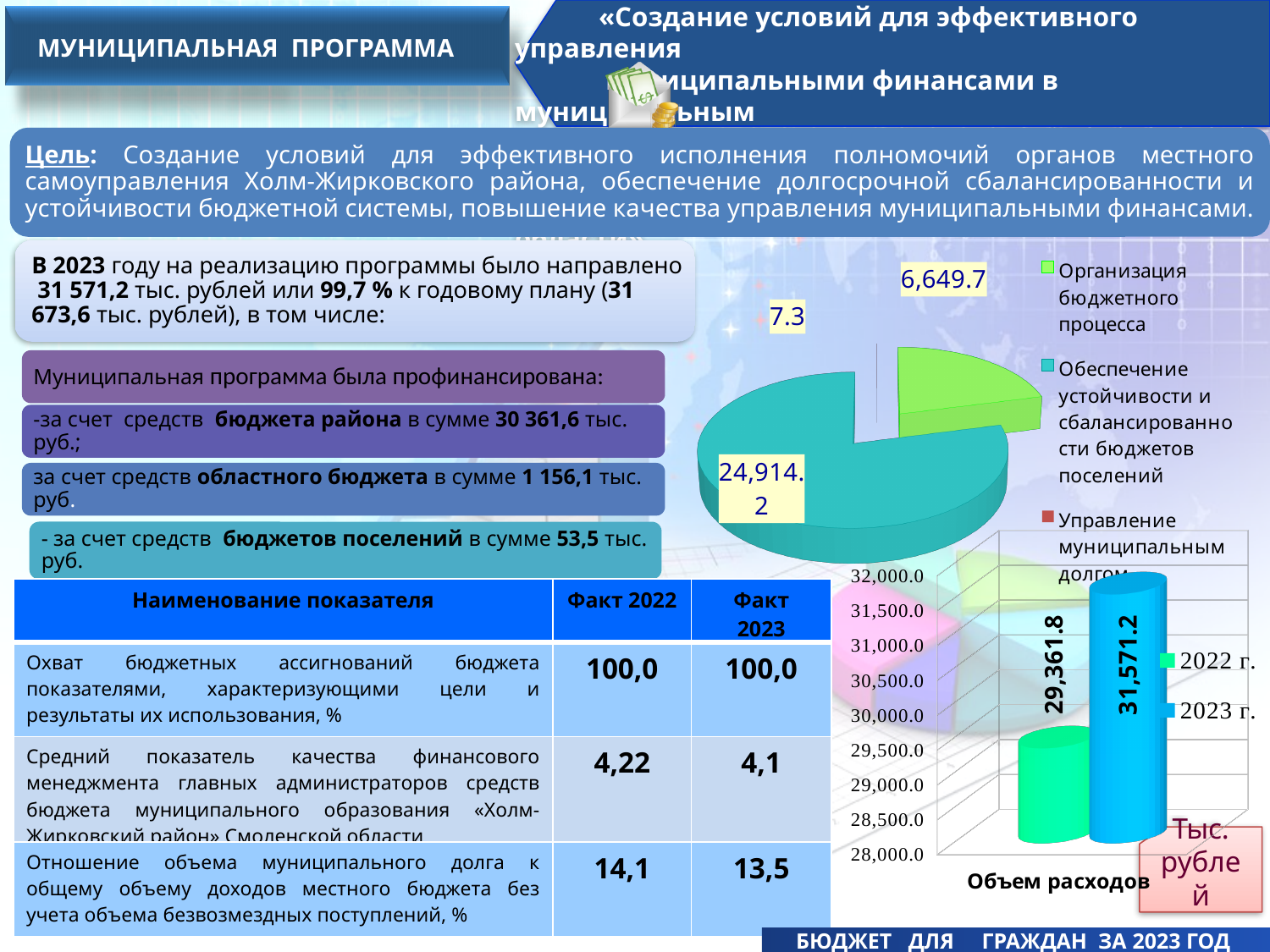
What kind of chart is the chart in the top right of the slide? pie chart In the bar chart Объем расходов, what is the difference between the 2023 г. and 2022 г. values? 2,209.4 In the bar chart Объем расходов, what is the value for 2023 г.? 31,571.2 How many categories does the legend of the pie chart in the top right list? 3 In the pie chart in the top right, what is the value for Управление муниципальным долгом? 7.3 In the bar chart Объем расходов, what is the value for 2022 г.? 29,361.8 In the pie chart in the top right, which category has the largest slice? Обеспечение устойчивости и сбалансированности бюджетов поселений In the pie chart in the top right, what is the value for Организация бюджетного процесса? 6,649.7 In the bar chart Объем расходов, is the value for 2022 г. greater or less than 30,000.0? less In the pie chart in the top right, what is the value for Обеспечение устойчивости и сбалансированности бюджетов поселений? 24,914.2 In the pie chart in the top right, which category has the smallest slice? Управление муниципальным долгом What kind of chart is the chart in the bottom right of the slide (Объем расходов)? bar chart